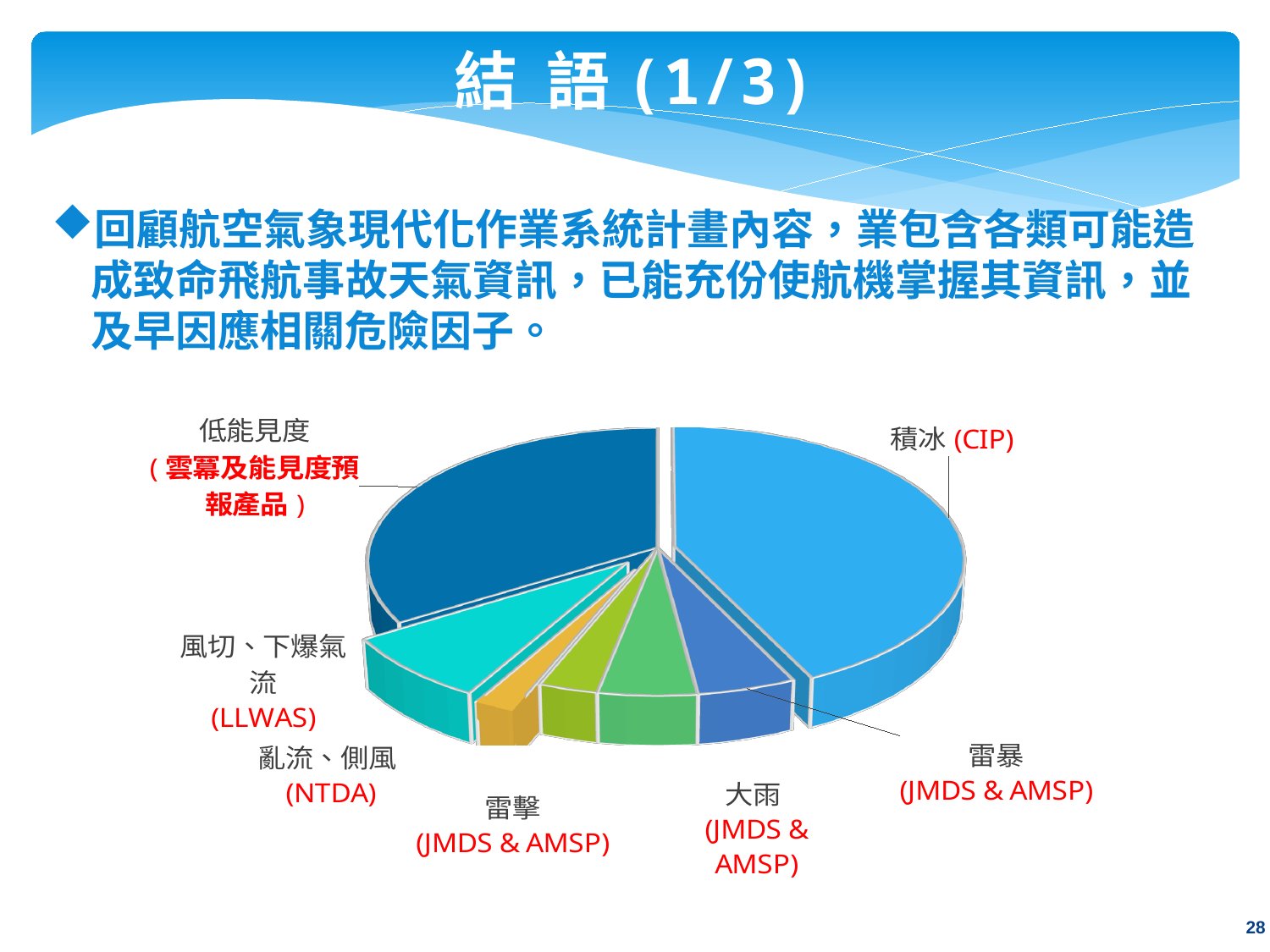
Which slice is larger, 積冰 (CIP) or 雷擊 (JMDS & AMSP)? 積冰 (CIP) What system name is shown in parentheses under the 風切、下爆氣流 label? LLWAS Which slice is larger, 積冰 (CIP) or 低能見度? 積冰 (CIP) Which category has the largest slice of the pie chart? 積冰 (CIP) What kind of chart is shown on the slide? pie chart Which category has the smallest slice of the pie chart? 亂流、側風 (NTDA) What colour is the 積冰 (CIP) slice of the pie chart? light blue Which slice is larger, 低能見度 or 風切、下爆氣流 (LLWAS)? 低能見度 How many slices does the pie chart have? 7